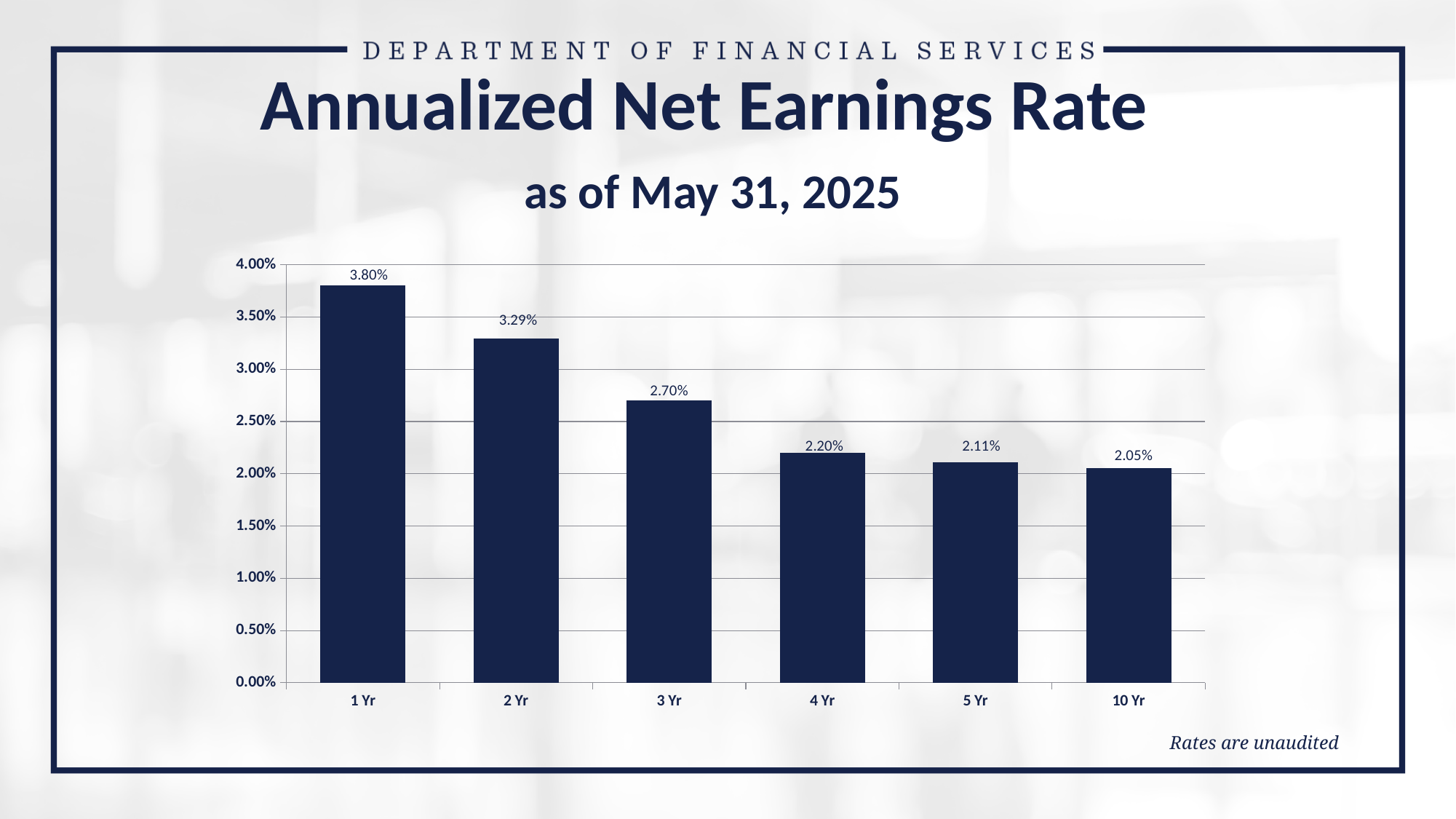
Which is larger, the 2 Yr rate or the 3 Yr rate? 2 Yr Which period has the highest annualized net earnings rate? 1 Yr What is the annualized net earnings rate for 1 Yr? 3.80% How many periods are shown on the chart? 6 What is the difference between the 4 Yr and 5 Yr rates? 0.09% What is the difference between the 1 Yr and 2 Yr rates? 0.51% Which period has the lowest annualized net earnings rate? 10 Yr What kind of chart is shown on the slide? Bar chart Do the rates rise or fall as the period lengthens from 1 Yr to 10 Yr? Fall What is the annualized net earnings rate for 10 Yr? 2.05% Is the value for 2 Yr greater or less than 3.00%? greater What is the annualized net earnings rate for 3 Yr? 2.70%